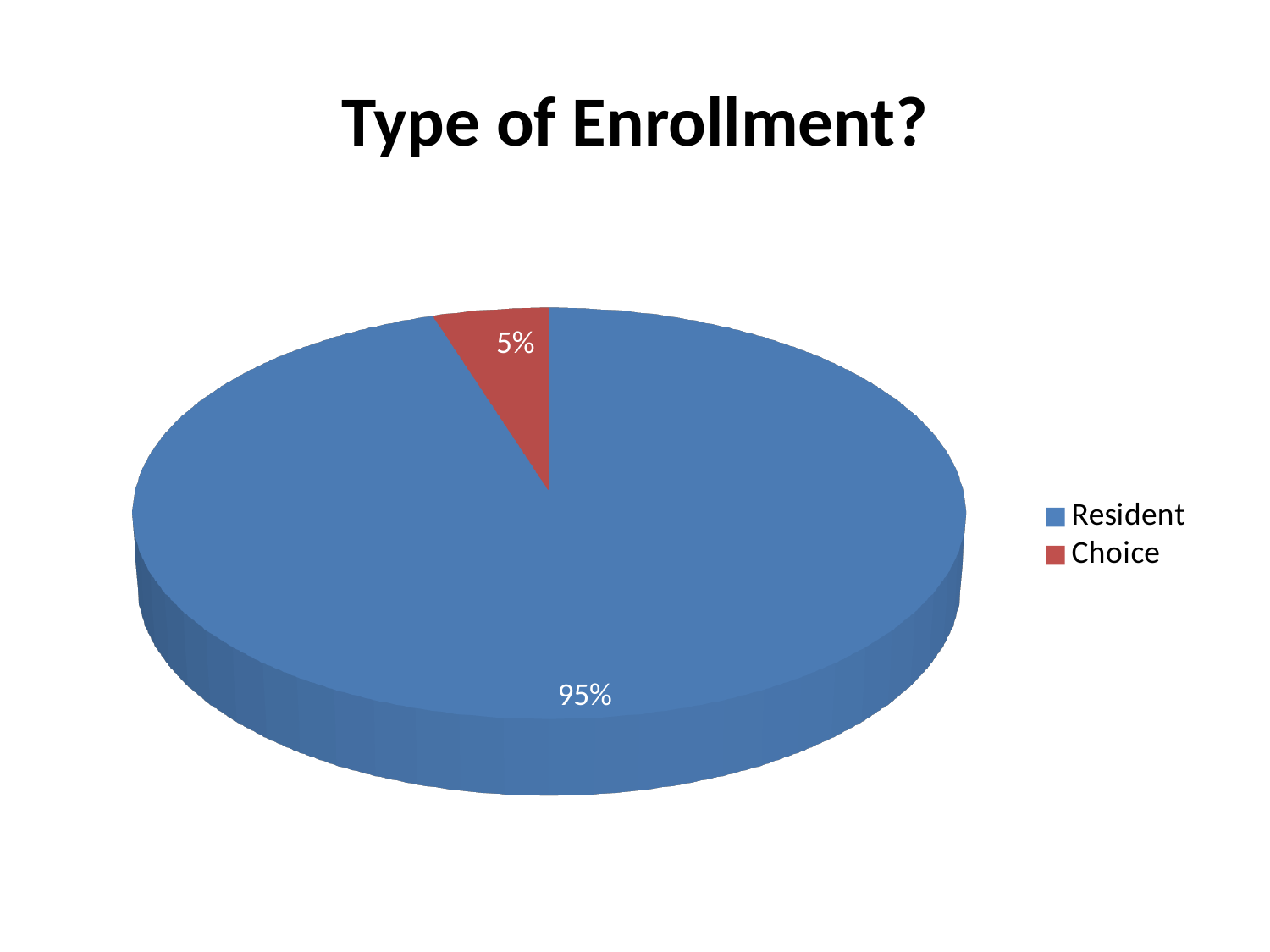
What is the difference in percentage points between Resident and Choice? 90 What percentage of the pie is Choice? 5% Which category has the smallest share of the pie? Choice What colour is the Choice slice? red Which category has the largest share of the pie? Resident How many entries does the legend list? 2 How many categories does the pie chart show? 2 What is the share of the pie taken by the Resident slice? 95% What percentage of the pie is Resident? 95% Which is larger, the Resident slice or the Choice slice? Resident What kind of chart is shown on the slide? pie chart What is the title of the chart? Type of Enrollment?